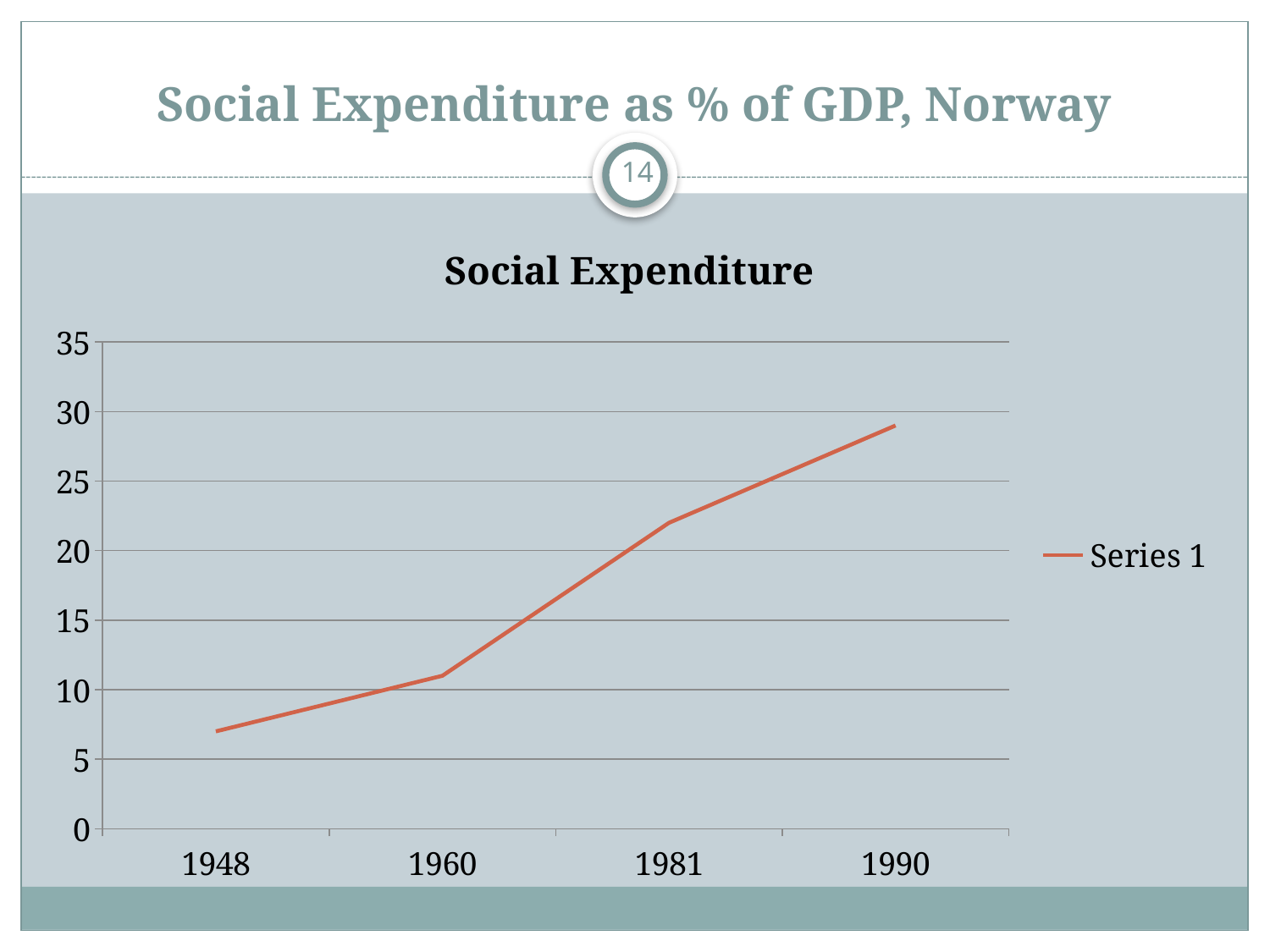
Is the value for 1990 greater or less than 25? greater Which year has the lowest value? 1948 What is the name of the series shown in the legend? Series 1 Is the value for 1948 greater or less than 10? less What kind of chart is shown on the slide? line chart How many series does the legend list? 1 Which is larger, the value for 1960 or the value for 1981? 1981 Do the values rise or fall from 1948 to 1990? rise Which year has the highest value? 1990 What is the title of the chart? Social Expenditure How many years are plotted on the x axis? 4 Is the value for 1981 greater or less than 20? greater